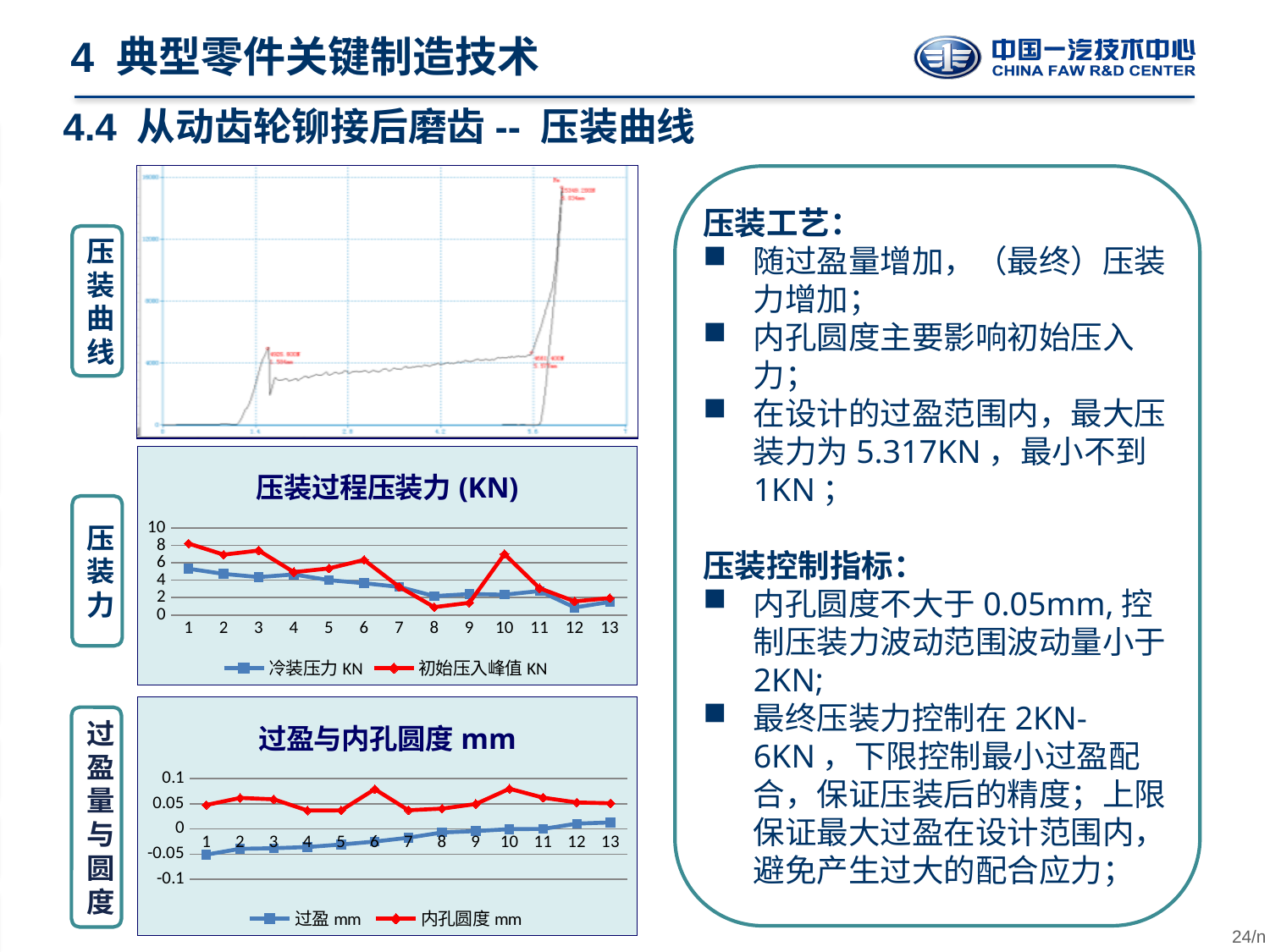
In the '压装过程压装力 (KN)' chart, at point 1, which series has the larger value, 冷装压力 KN or 初始压入峰值 KN? 初始压入峰值 KN What colour is the 内孔圆度 mm series in the '过盈与内孔圆度 mm' chart? red In the '压装过程压装力 (KN)' chart, does 冷装压力 KN generally rise or fall from point 1 to point 13? fall How many series does the legend of the '压装过程压装力 (KN)' chart list? 2 In the '过盈与内孔圆度 mm' chart, does 过盈 mm generally rise or fall from point 1 to point 13? rise In the '过盈与内孔圆度 mm' chart, is the value of 过盈 mm at point 1 greater or less than 0? less In the '压装过程压装力 (KN)' chart, is the value of 初始压入峰值 KN at point 8 greater or less than 2? less How many series does the legend of the '过盈与内孔圆度 mm' chart list? 2 In the '压装过程压装力 (KN)' chart, is the value of 初始压入峰值 KN at point 1 greater or less than 6? greater What kind of chart is the '压装过程压装力 (KN)' chart? line chart How many points are plotted along the x axis of the '压装过程压装力 (KN)' chart? 13 In the '压装过程压装力 (KN)' chart, at which point is 初始压入峰值 KN highest? 1